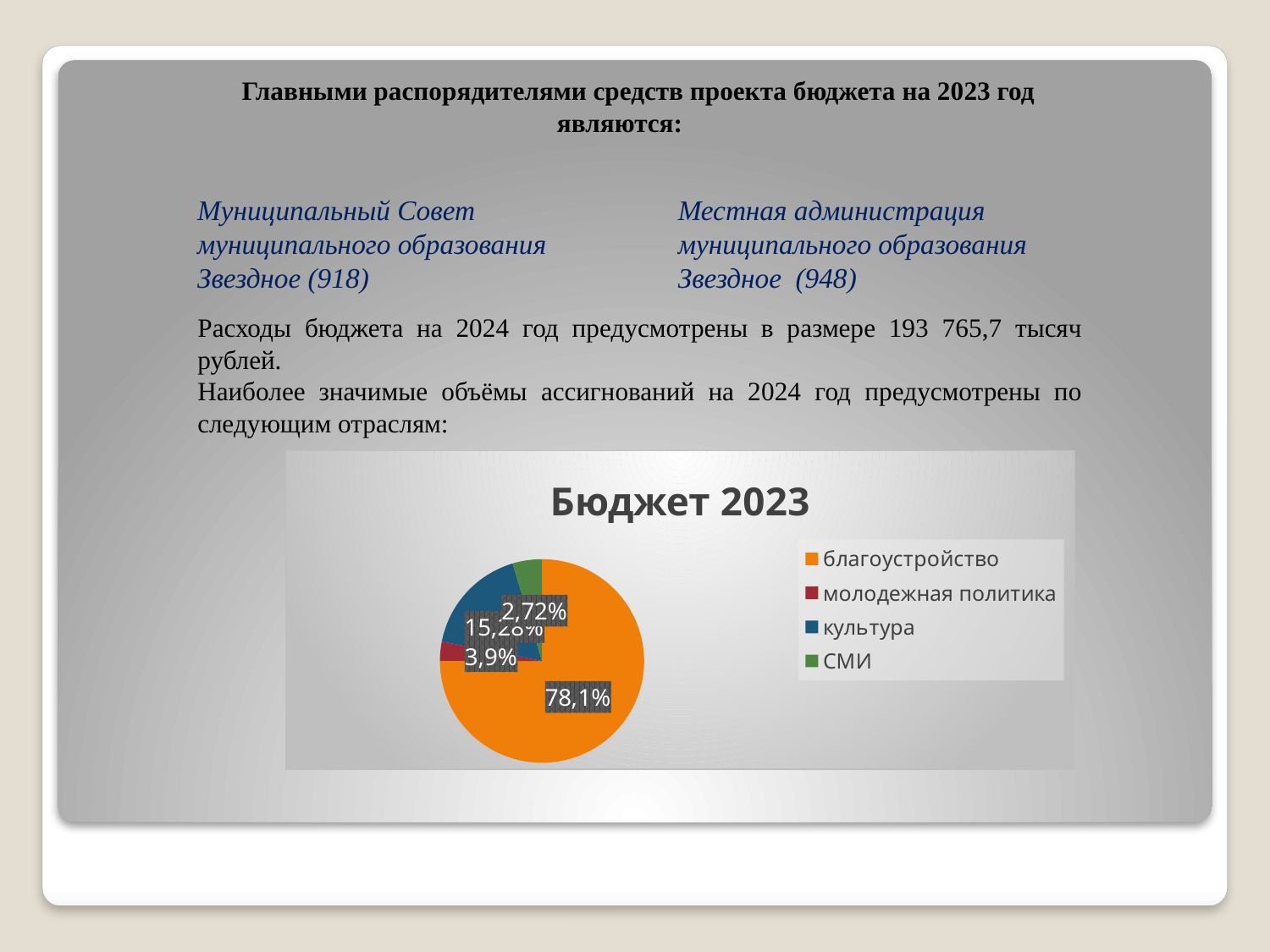
What share of the pie does СМИ have? 2,72% Which category has the largest slice of the pie? благоустройство How many categories does the legend of the pie chart list? 4 What is the title of the chart? Бюджет 2023 What kind of chart is shown on the slide? pie chart Which is larger, the slice for культура or the slice for молодежная политика? культура What share of the pie does молодежная политика have? 3,9% What share of the pie does благоустройство have? 78,1% What colour is the slice for благоустройство? orange What is the difference between the share for благоустройство and the share for молодежная политика? 74,2%